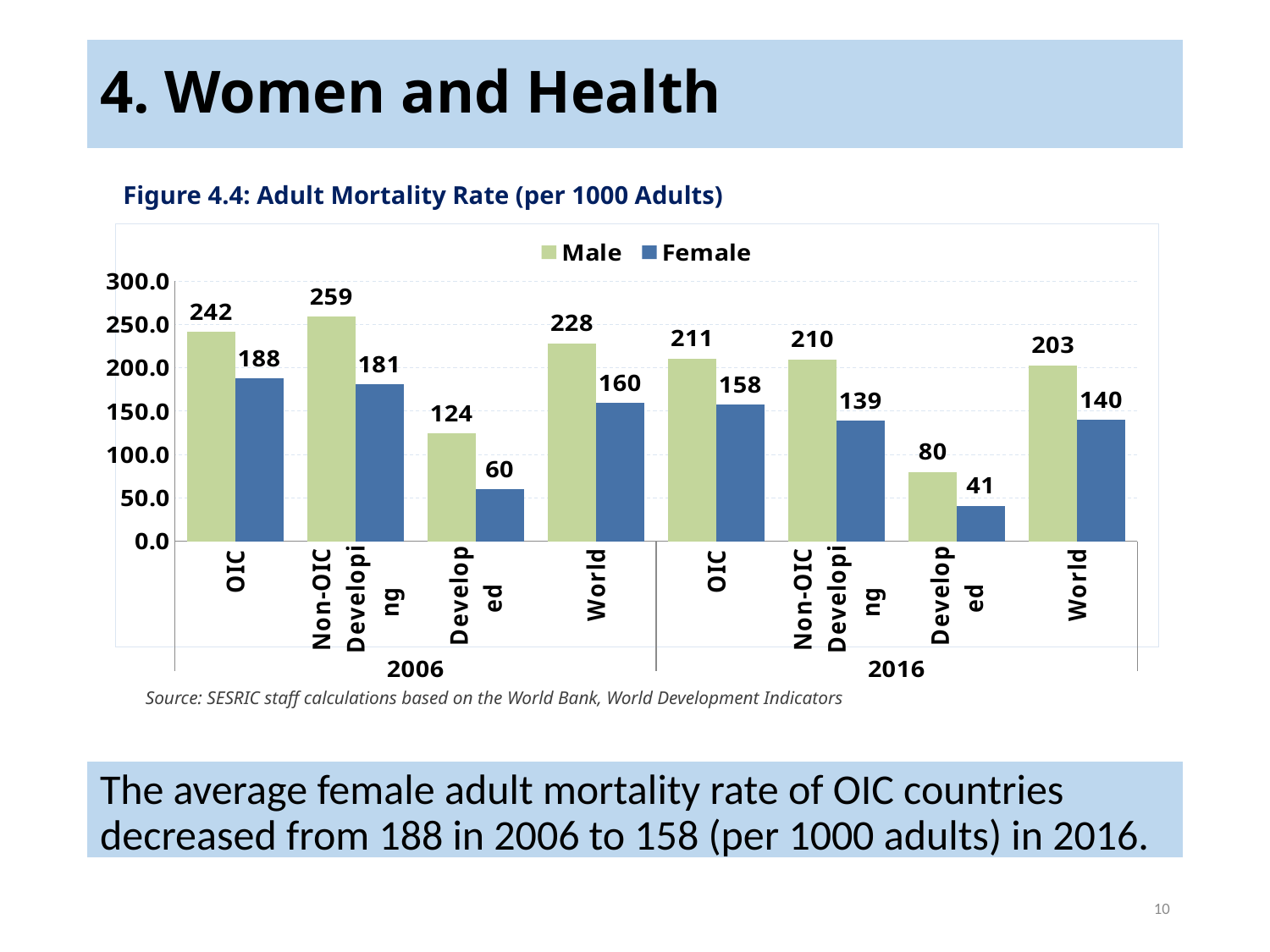
What is the Male adult mortality rate for OIC in 2006? 242 By how much did the Female adult mortality rate for OIC decrease from 2006 to 2016? 30 What kind of chart is shown in Figure 4.4? Bar chart What is the difference between the Male and Female adult mortality rates for OIC in 2016? 53 How many series does the legend list? 2 What is the Female adult mortality rate for Developed countries in 2016? 41 Which group and year has the highest Male adult mortality rate? Non-OIC Developing, 2006 Which group and year has the lowest Female adult mortality rate? Developed, 2016 How many category groups are shown on the x axis across both years? 8 Which is larger, the Male rate for World in 2016 or the Male rate for Non-OIC Developing in 2016? Non-OIC Developing in 2016 What is the Female adult mortality rate for World in 2006? 160 What colour represents the Female series in the chart? Blue